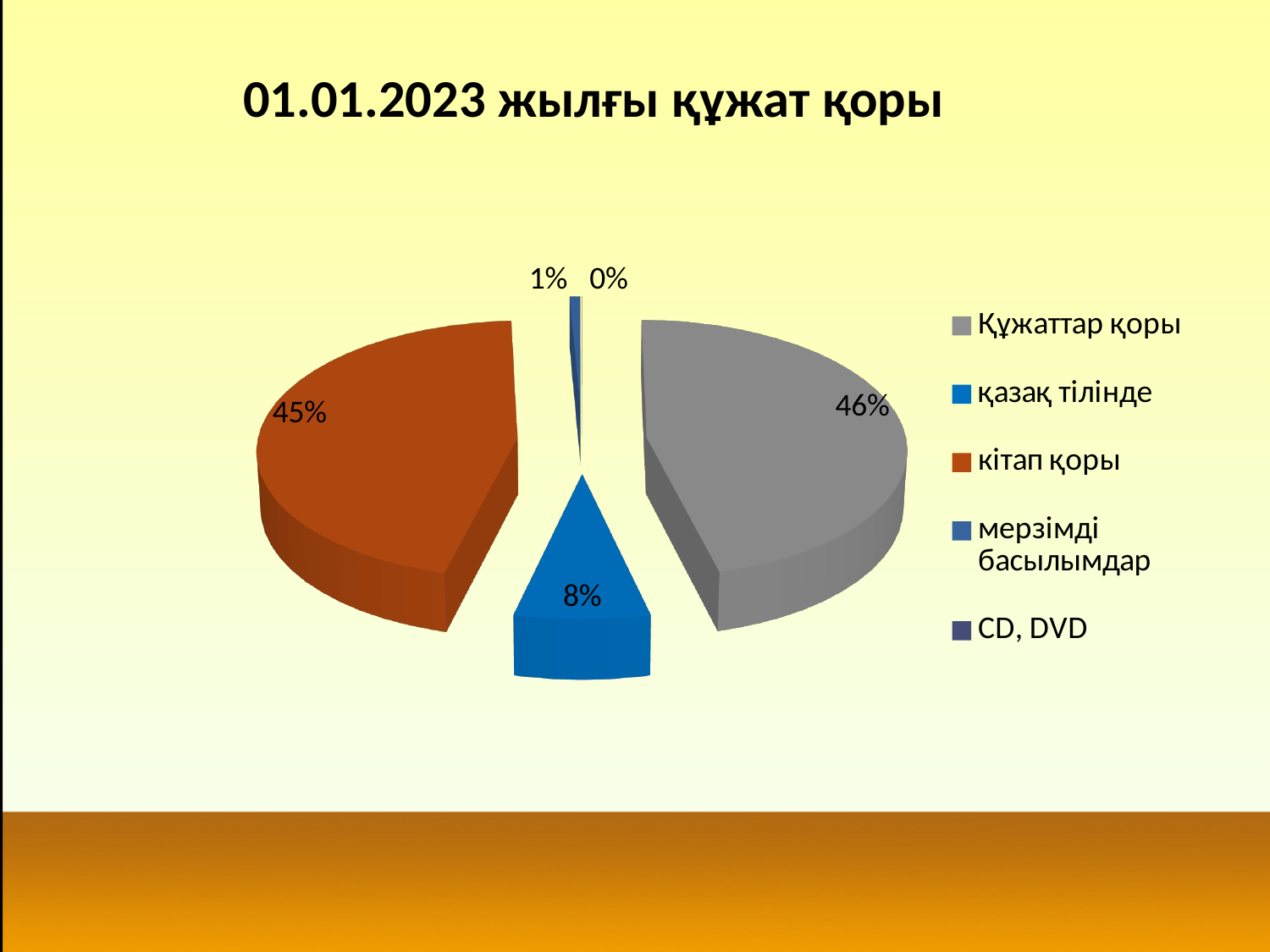
What share of the pie does CD, DVD have? 0% What share of the pie does кітап қоры have? 45% Which colour represents кітап қоры in the chart? orange-brown What kind of chart is shown on the slide? pie chart Which category has the largest slice of the pie? Құжаттар қоры What is the title of the chart? 01.01.2023 жылғы құжат қоры What share of the pie does мерзімді басылымдар have? 1% What is the difference between the shares of Құжаттар қоры and қазақ тілінде? 38% How many entries does the legend list? 5 Which category has the smallest slice of the pie? CD, DVD